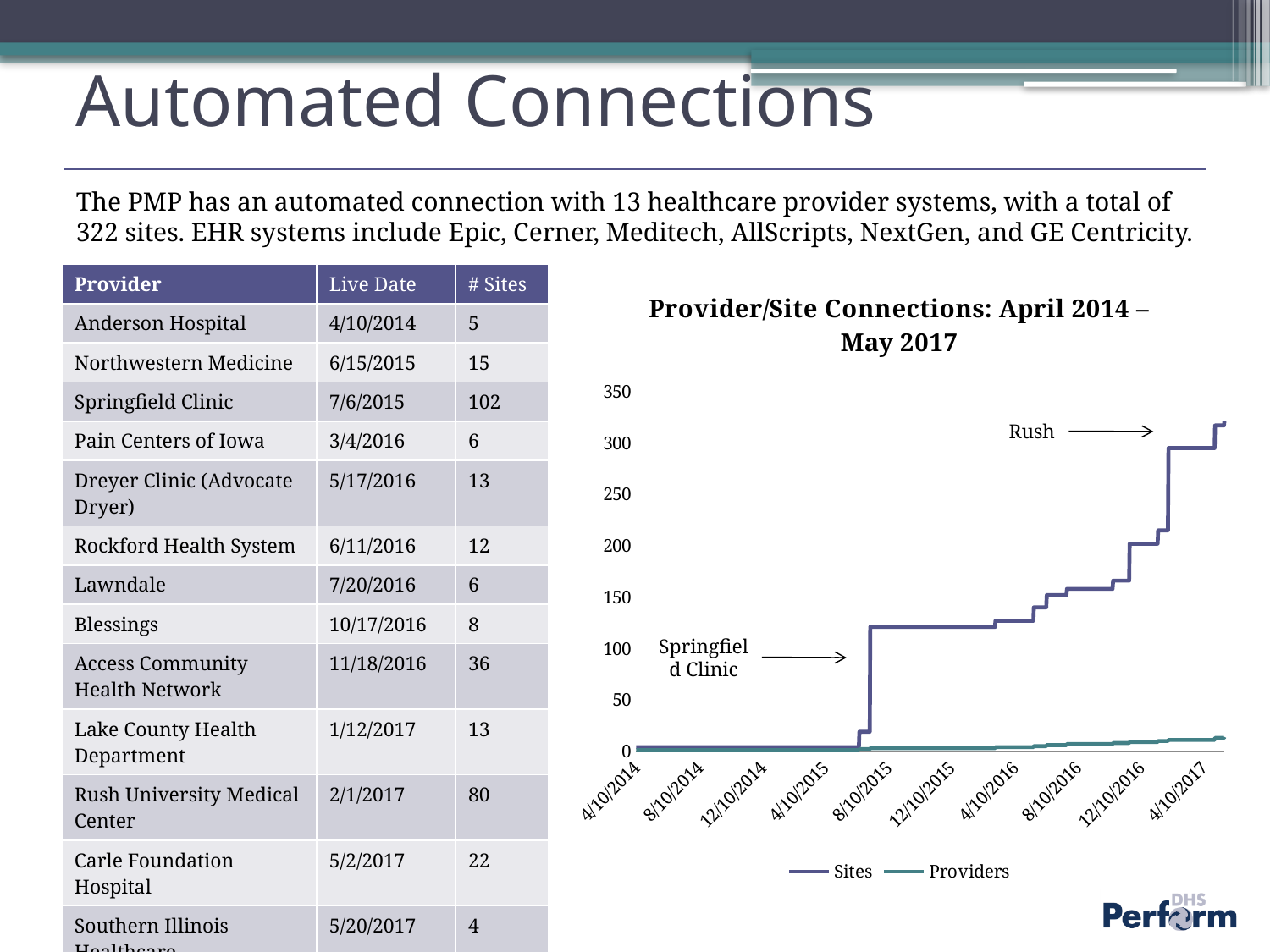
Does the Sites line rise or fall from 4/10/2014 to 4/10/2017? Rise Is the value of the Providers series at 4/10/2017 greater or less than 50? less What is the title of the chart? Provider/Site Connections: April 2014 – May 2017 Which two series are named in the chart's legend? Sites and Providers How many date labels are shown along the x axis of the chart? 10 Is the value of the Sites series at 8/10/2015 greater or less than 100? greater At 4/10/2017, which series has the larger value, Sites or Providers? Sites Is the value of the Sites series at 4/10/2015 greater or less than 50? less How many series does the chart's legend list? 2 What kind of chart is shown on the slide? Line chart Which series stays near the bottom of the chart throughout the period, Sites or Providers? Providers